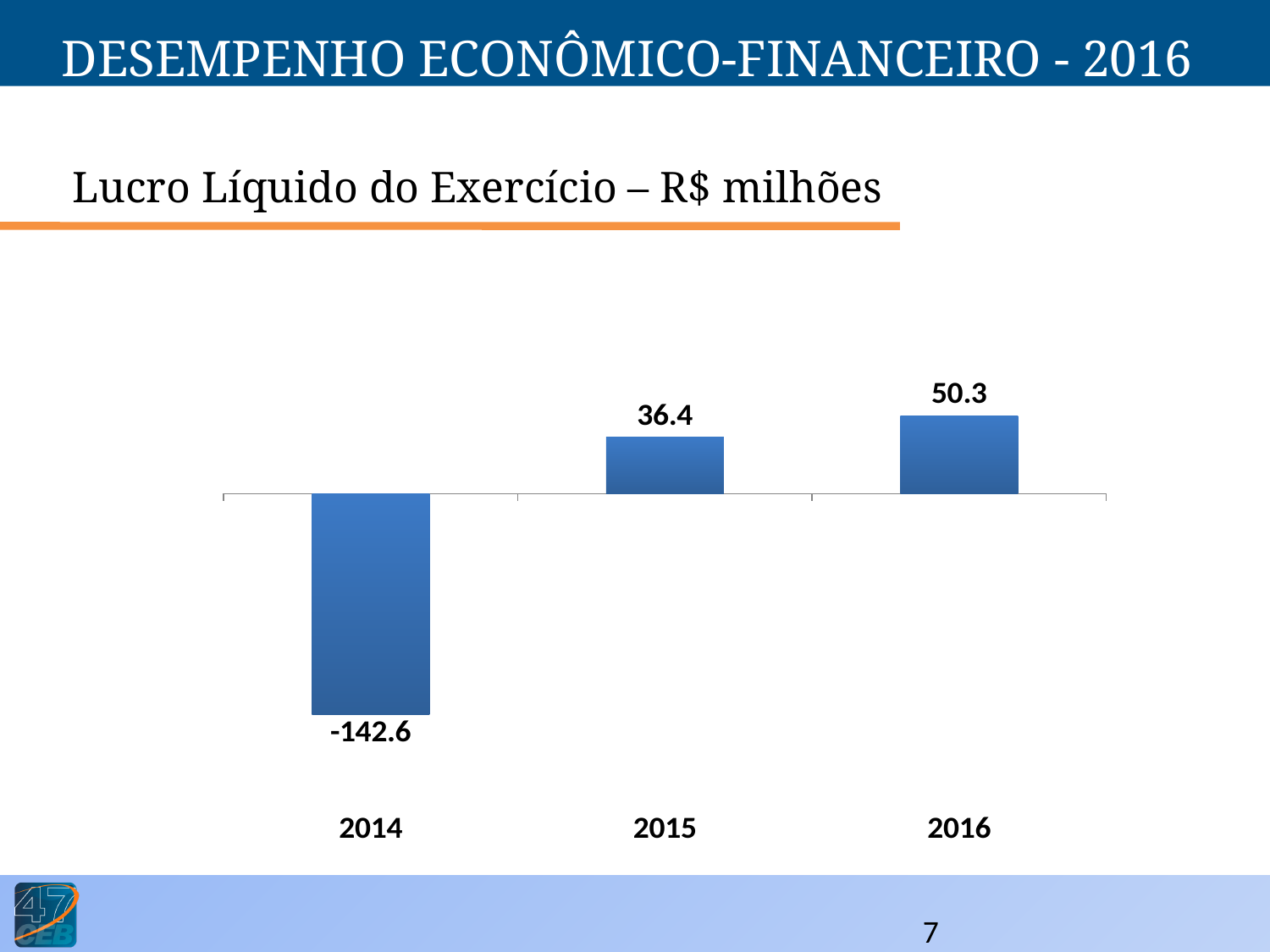
What is the net profit (Lucro Líquido) value for 2014? -142.6 Which year has the highest net profit? 2016 Which year has the lowest net profit? 2014 How many years are shown on the chart? 3 What is the difference between the 2016 and 2015 values? 13.9 What kind of chart is shown on the slide? Bar chart How many years show a negative value? 1 In what unit are the chart values expressed, according to the chart title? R$ milhões What is the net profit value for 2016? 50.3 What is the net profit value for 2015? 36.4 Which year has the larger value, 2015 or 2016? 2016 Do the values rise or fall from 2014 to 2016? Rise